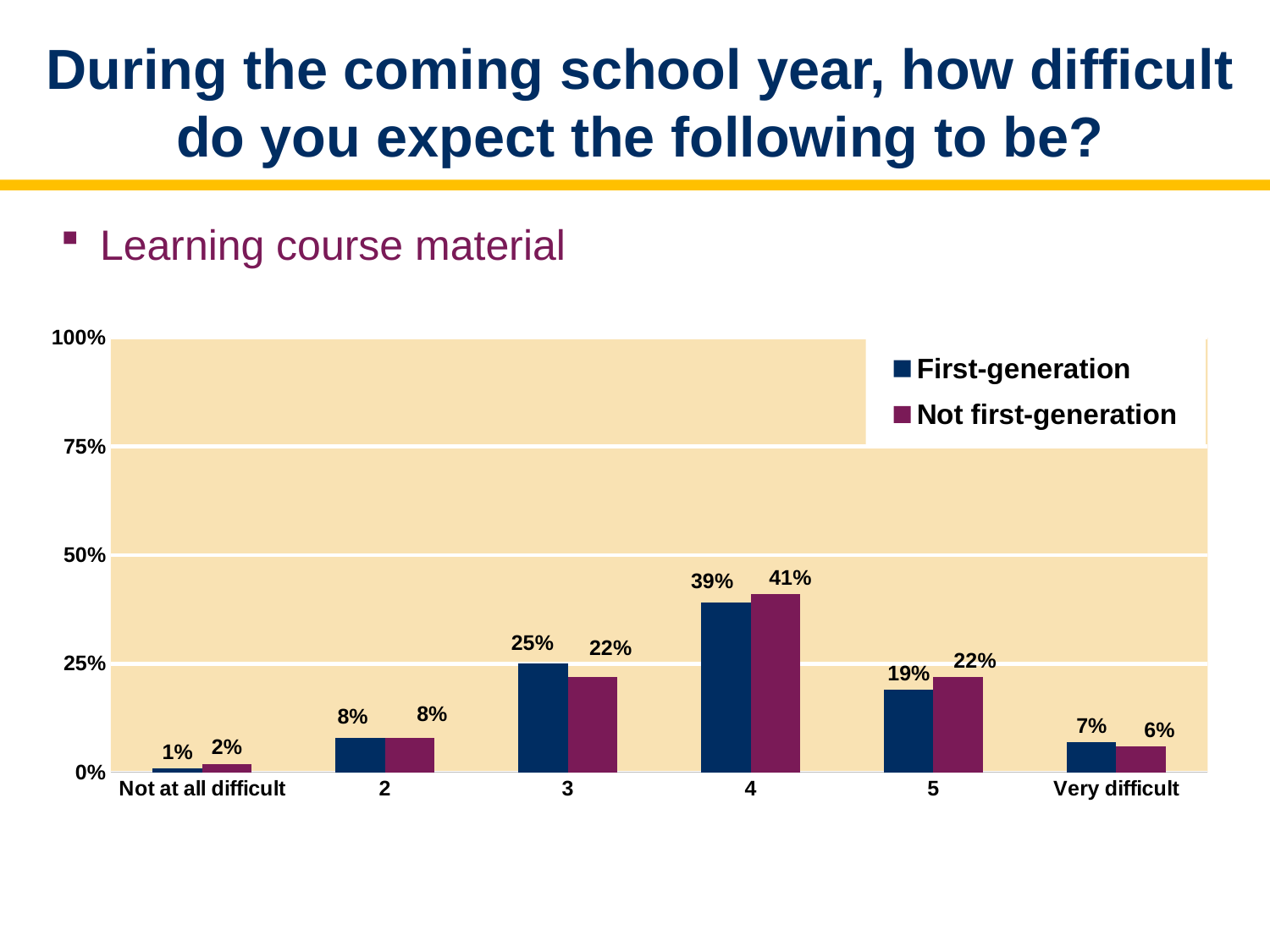
What percentage of First-generation students rated learning course material as 4? 39% How many series does the legend list? 2 Is the First-generation value for category 4 greater or less than 25%? greater Which category has the lowest value for First-generation? Not at all difficult How many categories are shown on the x axis? 6 Which category has the highest value for Not first-generation? 4 Which series is shown in dark blue? First-generation What is the Not first-generation value for the category 3? 22% What kind of chart is shown on the slide? Bar chart For category 3, which series has the larger value, First-generation or Not first-generation? First-generation What is the difference between the Not first-generation and First-generation values for category 5? 3% What is the First-generation value for Very difficult? 7%